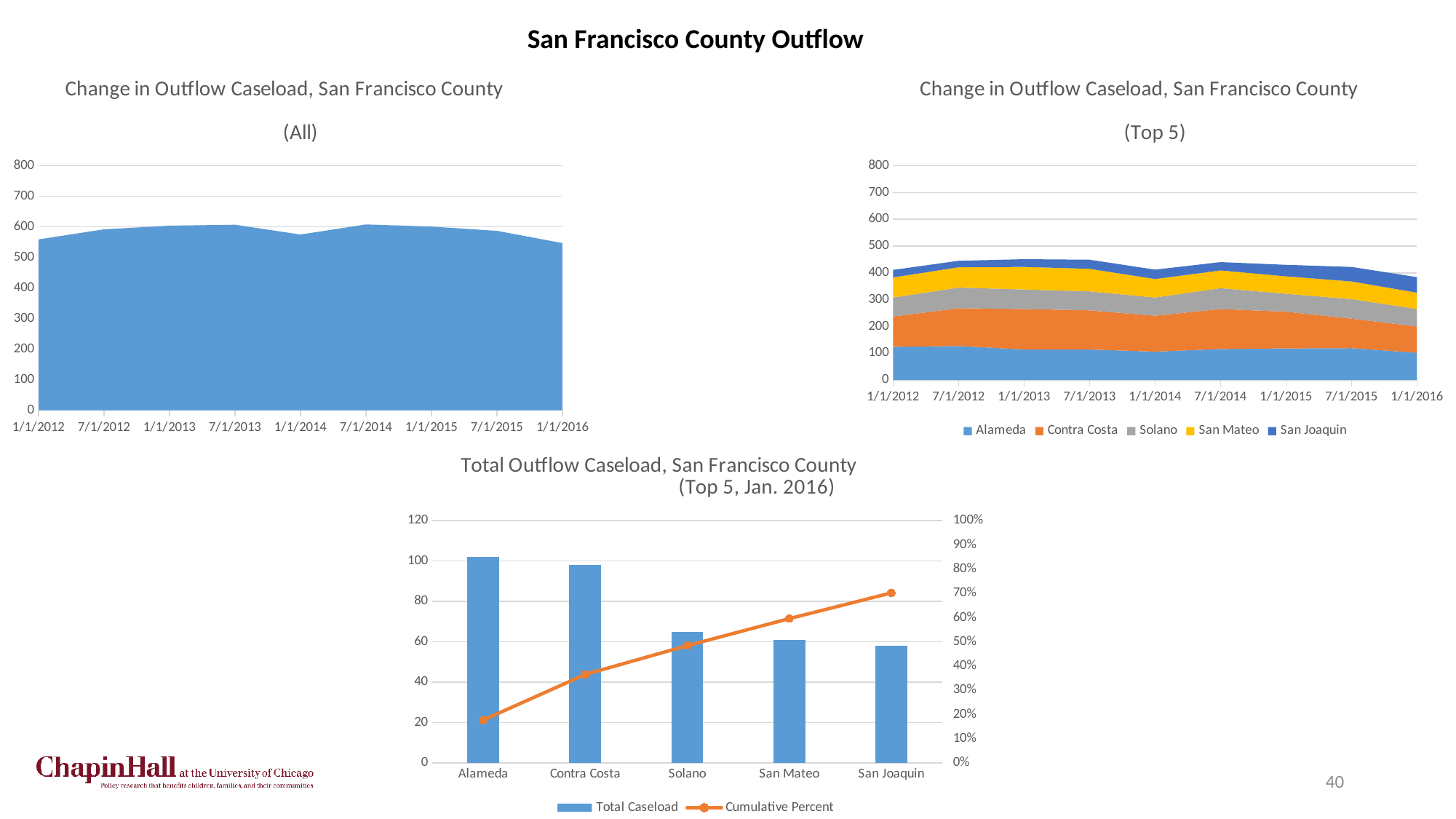
What kind of chart is the top-right chart (Change in Outflow Caseload, Top 5)? stacked area chart In the top-left chart (Change in Outflow Caseload, All), is the value at 1/1/2016 greater or less than 500? greater In the bottom chart (Total Outflow Caseload, Top 5, Jan. 2016), is the total caseload for Contra Costa greater or less than 80? greater In the bottom chart (Total Outflow Caseload, Top 5, Jan. 2016), which county has the highest total caseload? Alameda In the bottom chart (Total Outflow Caseload, Top 5, Jan. 2016), is the cumulative percent at San Joaquin greater or less than 60%? greater In the bottom chart (Total Outflow Caseload, Top 5, Jan. 2016), which has a larger total caseload, Alameda or Solano? Alameda How many counties are shown on the x axis of the bottom chart (Total Outflow Caseload, Top 5, Jan. 2016)? 5 In the top-right chart (Change in Outflow Caseload, Top 5), which series is shown in yellow? San Mateo How many series does the legend of the top-right chart (Change in Outflow Caseload, Top 5) list? 5 How many series does the legend of the bottom chart (Total Outflow Caseload, Top 5, Jan. 2016) list? 2